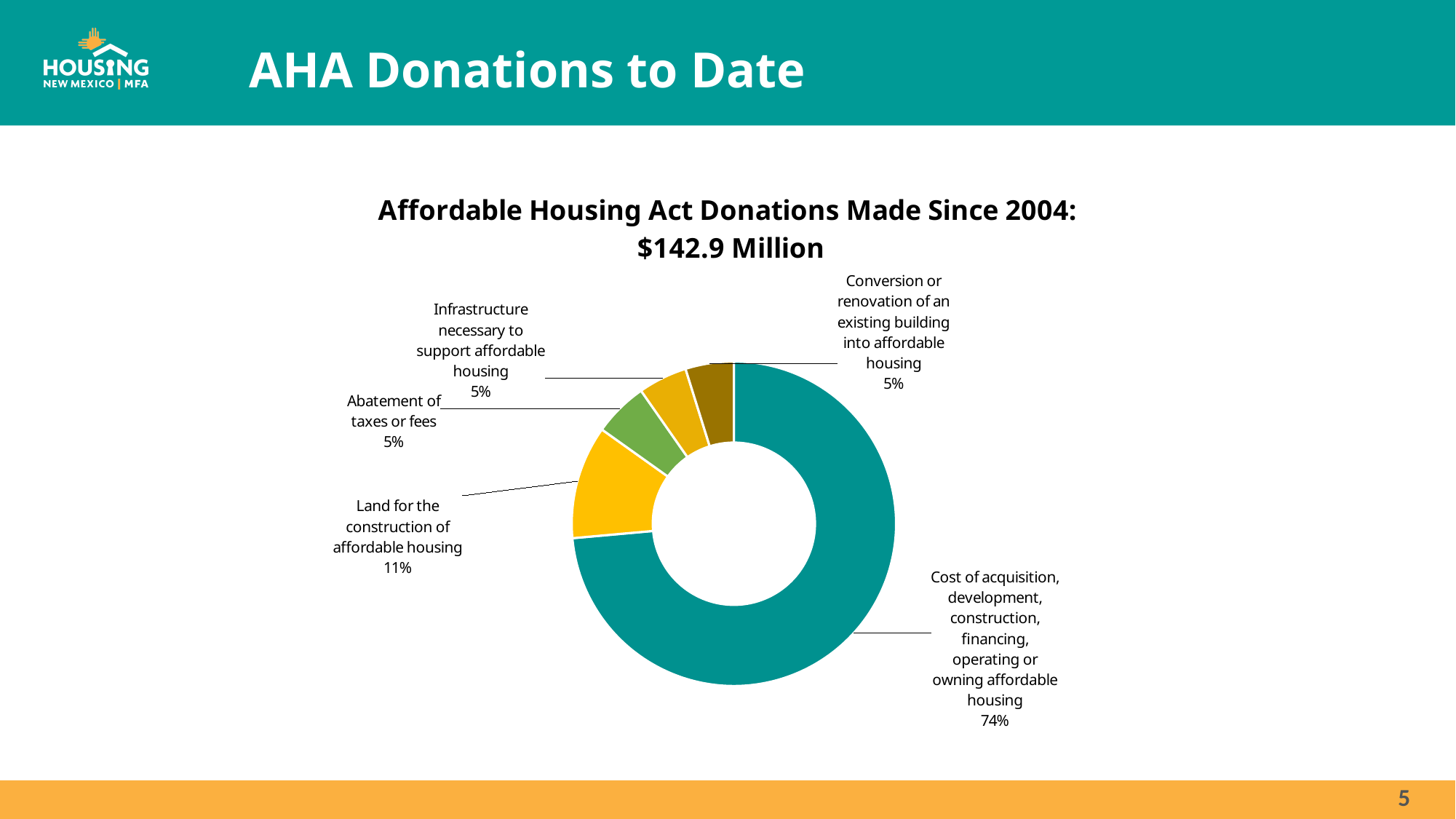
What share of donations went to conversion or renovation of an existing building into affordable housing? 5% What share of donations went to land for the construction of affordable housing? 11% What is the title of the chart? Affordable Housing Act Donations Made Since 2004: $142.9 Million Which category received the largest share of donations? Cost of acquisition, development, construction, financing, operating or owning affordable housing What share of donations went to abatement of taxes or fees? 5% What total dollar amount of donations does the chart title state? $142.9 Million What kind of chart is shown on the slide? Pie chart (donut) How many categories does the pie chart show? 5 Which is larger: the share for land for the construction of affordable housing or the share for abatement of taxes or fees? Land for the construction of affordable housing By how many percentage points does the largest slice exceed the share for land for the construction of affordable housing? 63 percentage points